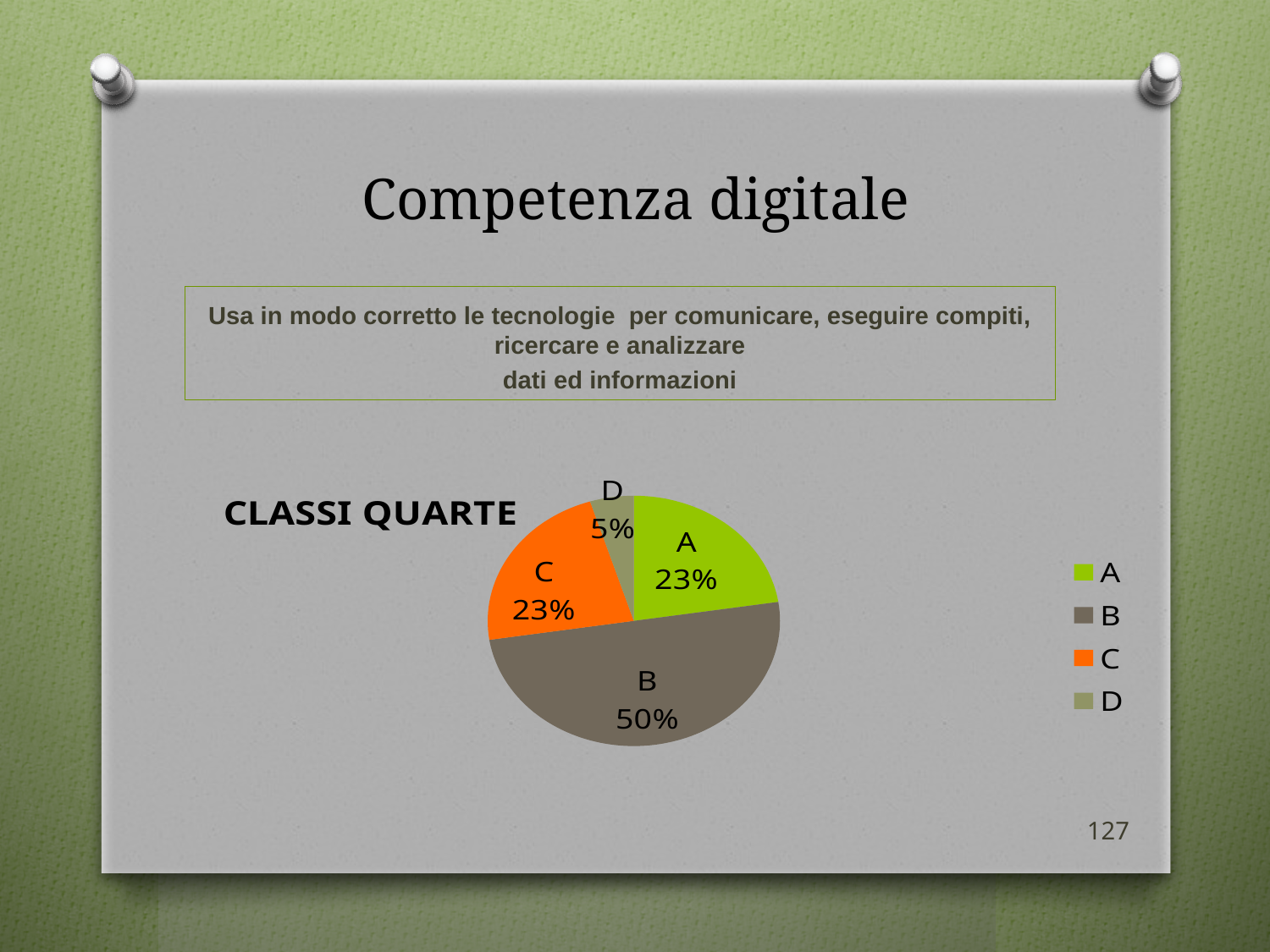
Which slice of the pie is the smallest? D What is the difference between the shares of B and D? 45% What kind of chart is shown on the slide? pie chart What label appears to the left of the pie chart? CLASSI QUARTE How many slices does the pie chart have? 4 Which is larger, the share of B or the share of C? B What share of the pie does slice D represent? 5% Which slice of the pie is the largest? B What share of the pie does slice A represent? 23% What is the difference between the shares of A and D? 18% What is the value shown for slice C? 23% What share of the pie does slice B represent? 50%